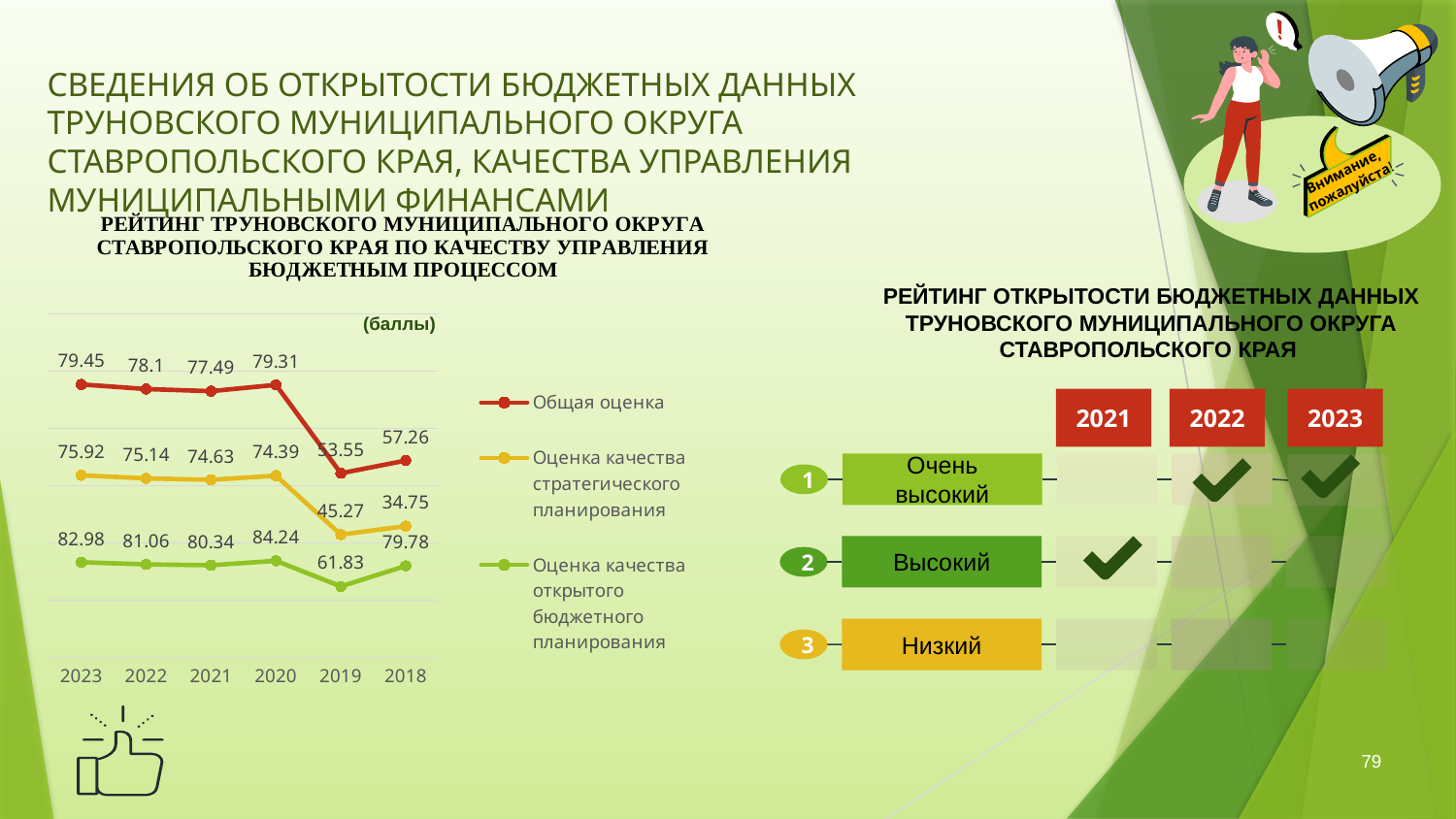
For 2019, which is larger: Оценка качества открытого бюджетного планирования or Оценка качества стратегического планирования? Оценка качества открытого бюджетного планирования In which year is Оценка качества открытого бюджетного планирования highest? 2020 In which year is Оценка качества стратегического планирования lowest? 2018 How many series does the chart legend list? 3 Do the values of Оценка качества стратегического планирования rise or fall moving left to right along the x axis from 2023 to 2018? fall What is the value of Оценка качества открытого бюджетного планирования for 2020? 84.24 How many years are shown on the x axis of the chart? 6 What is the value of Оценка качества стратегического планирования for 2018? 34.75 What kind of chart is shown on the slide? line chart What is the difference between the 2023 and 2022 values of Оценка качества открытого бюджетного планирования? 1.92 What is the value of Общая оценка for 2023? 79.45 What unit is indicated in the top right corner of the chart? баллы